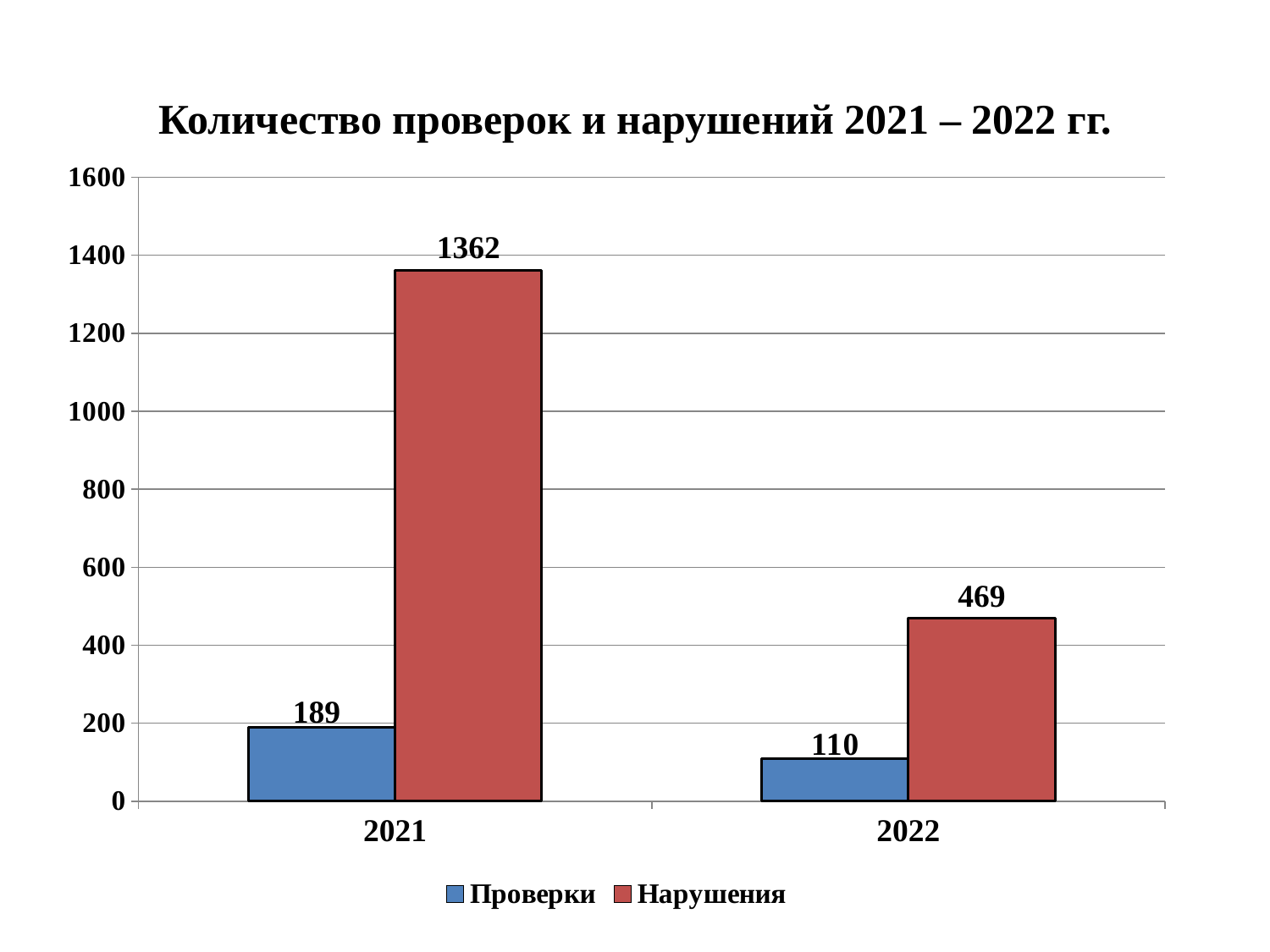
What is the value for Нарушения in 2021? 1362 In which year is the value for Проверки lowest? 2022 What is the difference between Нарушения in 2021 and Нарушения in 2022? 893 What is the value for Проверки in 2021? 189 Do the values for Нарушения rise or fall from 2021 to 2022? Fall How many series does the legend list? 2 What is the value for Проверки in 2022? 110 Which is larger: Проверки in 2021 or Нарушения in 2022? Нарушения in 2022 What is the difference between Проверки in 2021 and Проверки in 2022? 79 What kind of chart is shown on the slide? Bar chart In which year is the value for Нарушения highest? 2021 What is the value for Нарушения in 2022? 469